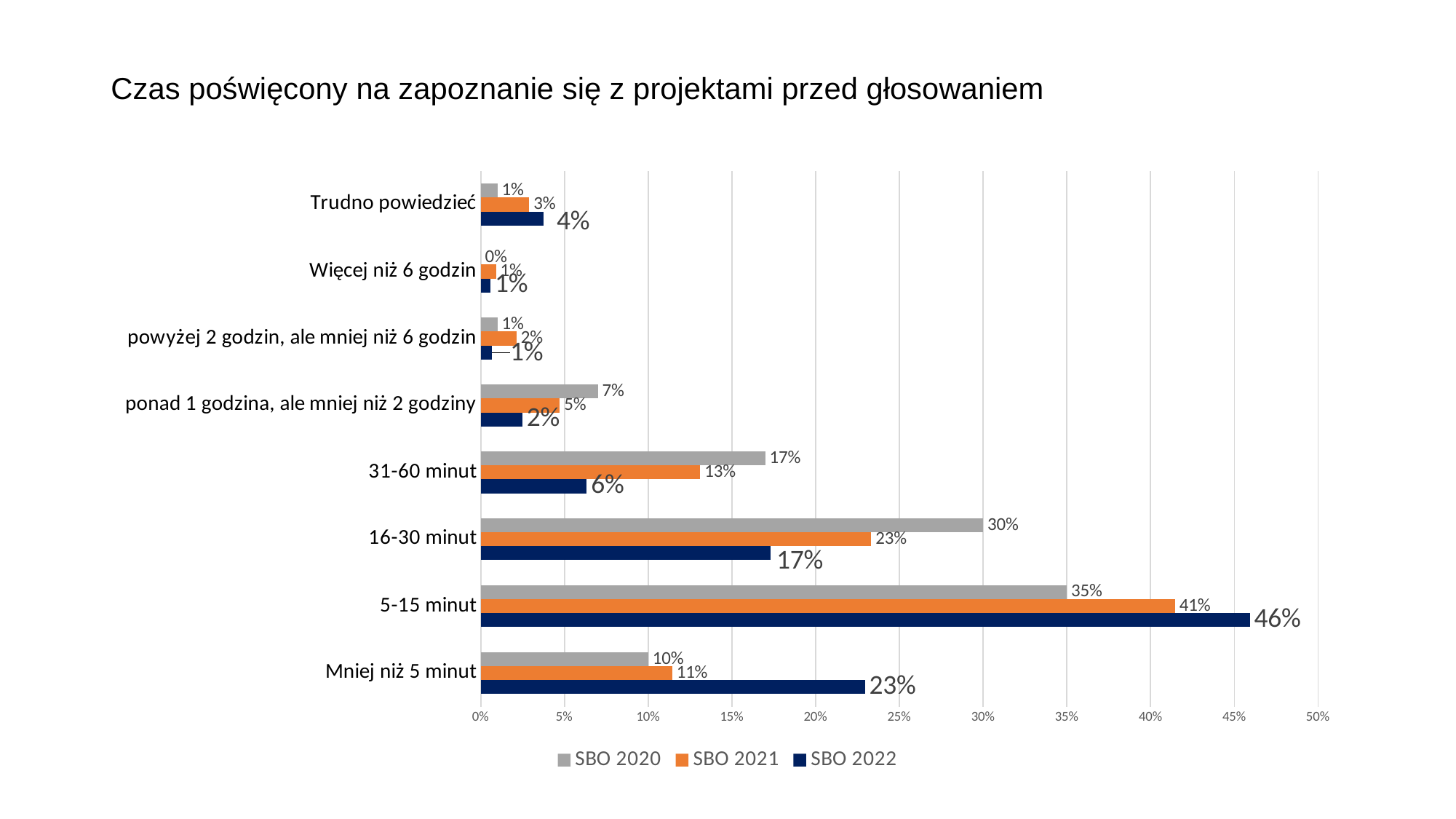
Which is larger for "16-30 minut": the SBO 2021 value or the SBO 2022 value? SBO 2021 Which category has the lowest value for SBO 2020? Więcej niż 6 godzin What kind of chart is shown on the slide? Bar chart What is the title of the chart? Czas poświęcony na zapoznanie się z projektami przed głosowaniem How many categories are shown on the chart? 8 Which category has the highest value for SBO 2022? 5-15 minut What is the value for SBO 2021 in the "31-60 minut" category? 13% What is the value for SBO 2022 in the "5-15 minut" category? 46% How many series does the legend list? 3 What is the value for SBO 2020 in the "16-30 minut" category? 30% What is the difference between the SBO 2022 and SBO 2020 values for "Mniej niż 5 minut"? 13% Which series is shown in orange in the legend? SBO 2021